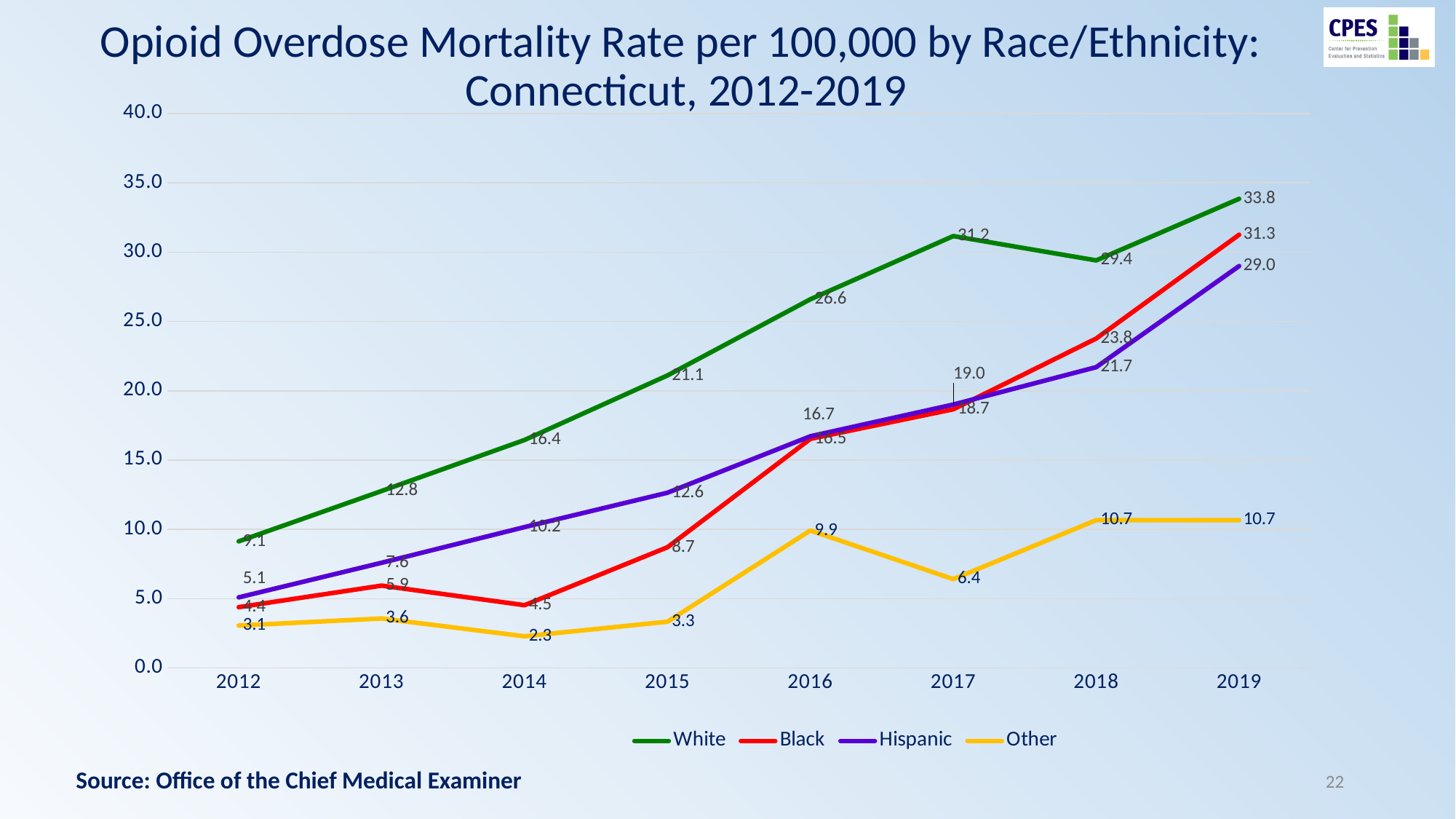
What is the opioid overdose mortality rate for White in 2019? 33.8 In which year is the White rate highest? 2019 How many series does the legend list? 4 What kind of chart is shown on the slide? Line chart What colour is the line for White? Green In 2018, which is larger, the Black rate or the Hispanic rate? Black How many years are plotted along the x axis? 8 What is the value for Other in 2014? 2.3 What is the value for Black in 2015? 8.7 What is the difference between the White and Black rates in 2019? 2.5 Does the Hispanic rate rise or fall from 2012 to 2019? Rise In which year is the Other rate lowest? 2014